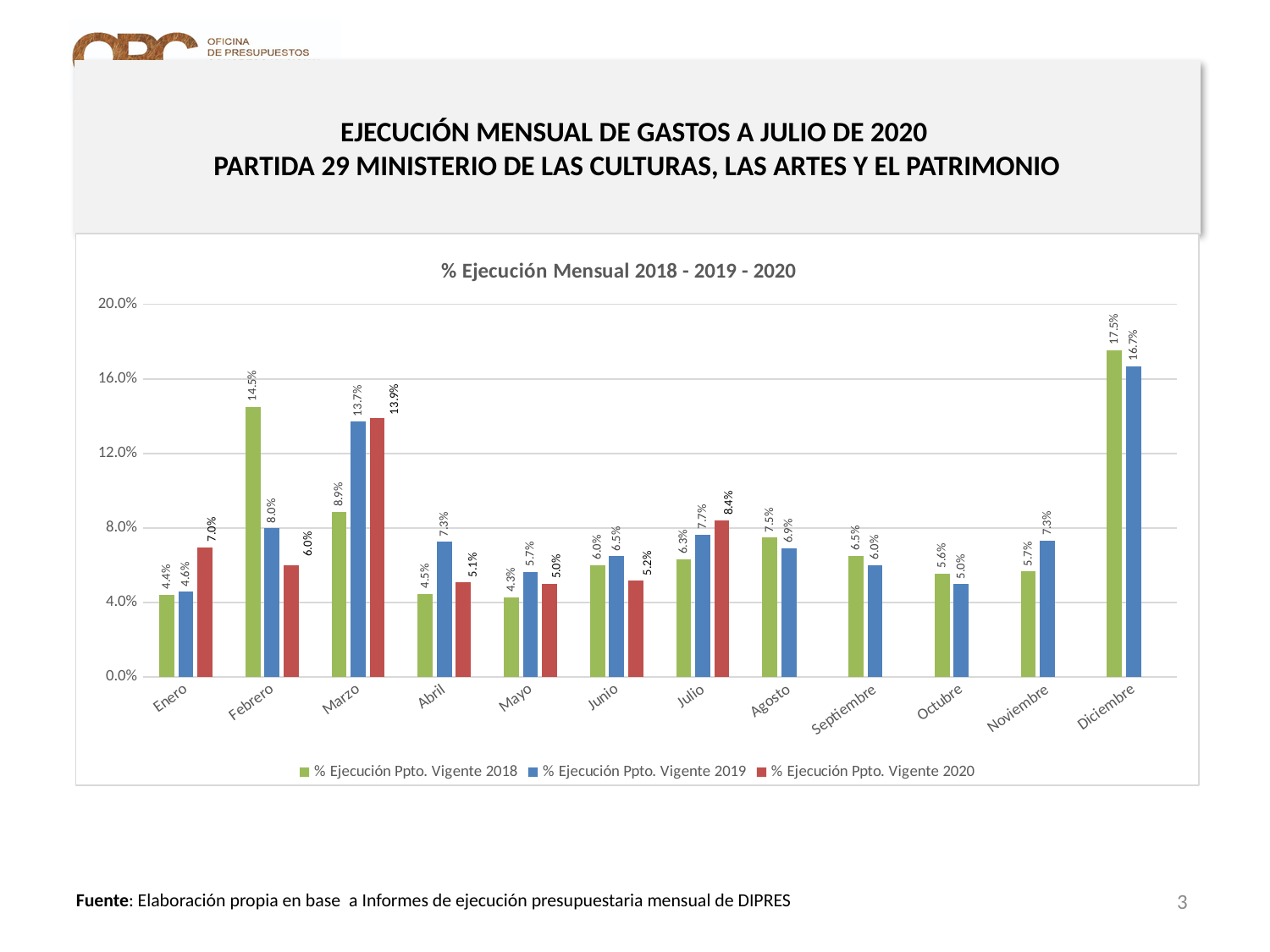
What is the value of % Ejecución Ppto. Vigente 2018 for Diciembre? 17.5% What is the value of % Ejecución Ppto. Vigente 2019 for Abril? 7.3% Which month has the highest value for % Ejecución Ppto. Vigente 2020? Marzo Which month has the lowest value for % Ejecución Ppto. Vigente 2018? Mayo How many series does the legend list? 3 Is the value for % Ejecución Ppto. Vigente 2019 in Diciembre greater or less than 16.0%? greater What is the difference between the 2018 and 2019 values for Febrero? 6.5% What is the value of % Ejecución Ppto. Vigente 2020 for Marzo? 13.9% What is the title of the chart? % Ejecución Mensual 2018 - 2019 - 2020 How many months are shown on the x axis? 12 Which is larger for Julio: the 2019 value or the 2020 value? 2020 value (8.4%) What kind of chart is shown on the slide? Bar chart